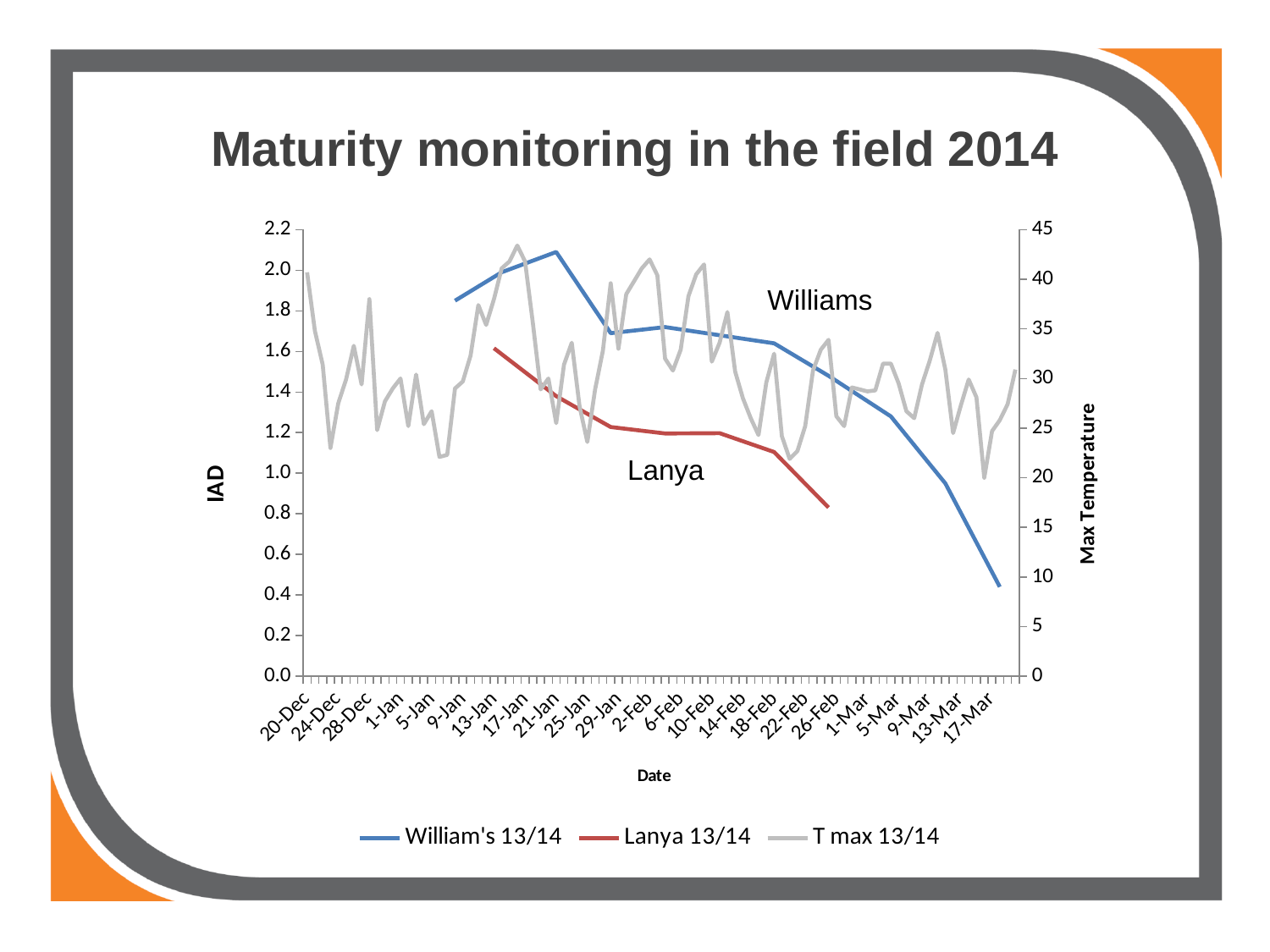
Does the Lanya 13/14 line rise or fall from 13-Jan to 26-Feb? fall Does the William's 13/14 line rise or fall between 21-Jan and 17-Mar? fall What is the label of the left vertical axis? IAD What kind of chart is shown on the slide? line chart Is the IAD value for Lanya 13/14 at 26-Feb greater or less than 1.0? less How many series does the legend list? 3 Is the IAD value for William's 13/14 at 17-Mar greater or less than 1.0? less What is the title of the chart on the slide? Maturity monitoring in the field 2014 Which series reaches the highest IAD value on the chart, William's 13/14 or Lanya 13/14? William's 13/14 At 29-Jan, which series has the higher IAD value, William's 13/14 or Lanya 13/14? William's 13/14 Is the IAD value for William's 13/14 at 21-Jan greater or less than 2.0? greater